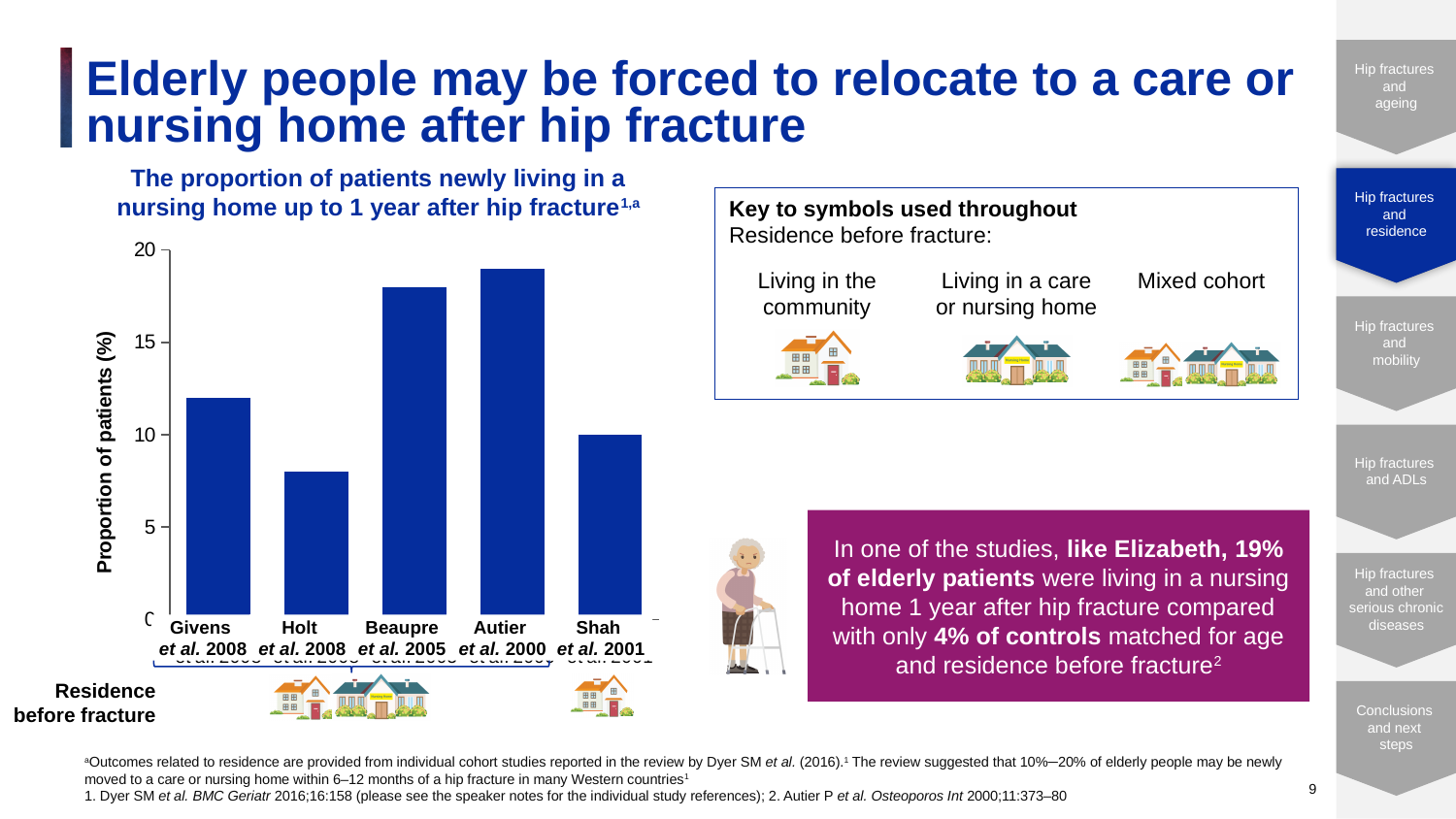
Is the value for Givens et al. 2008 greater or less than 10? greater Is the value for Beaupre et al. 2005 greater or less than 15? greater Is the value for Shah et al. 2001 greater or less than 15? less Which study has the lowest proportion of patients newly living in a nursing home? Holt et al. 2008 What is the highest value shown on the y-axis of the chart? 20 Which is larger, the value for Shah et al. 2001 or Beaupre et al. 2005? Beaupre et al. 2005 What kind of chart is shown on the slide? bar chart How many studies (bars) are shown in the chart? 5 What is the label of the y-axis of the chart? Proportion of patients (%) Which is larger, the value for Givens et al. 2008 or Holt et al. 2008? Givens et al. 2008